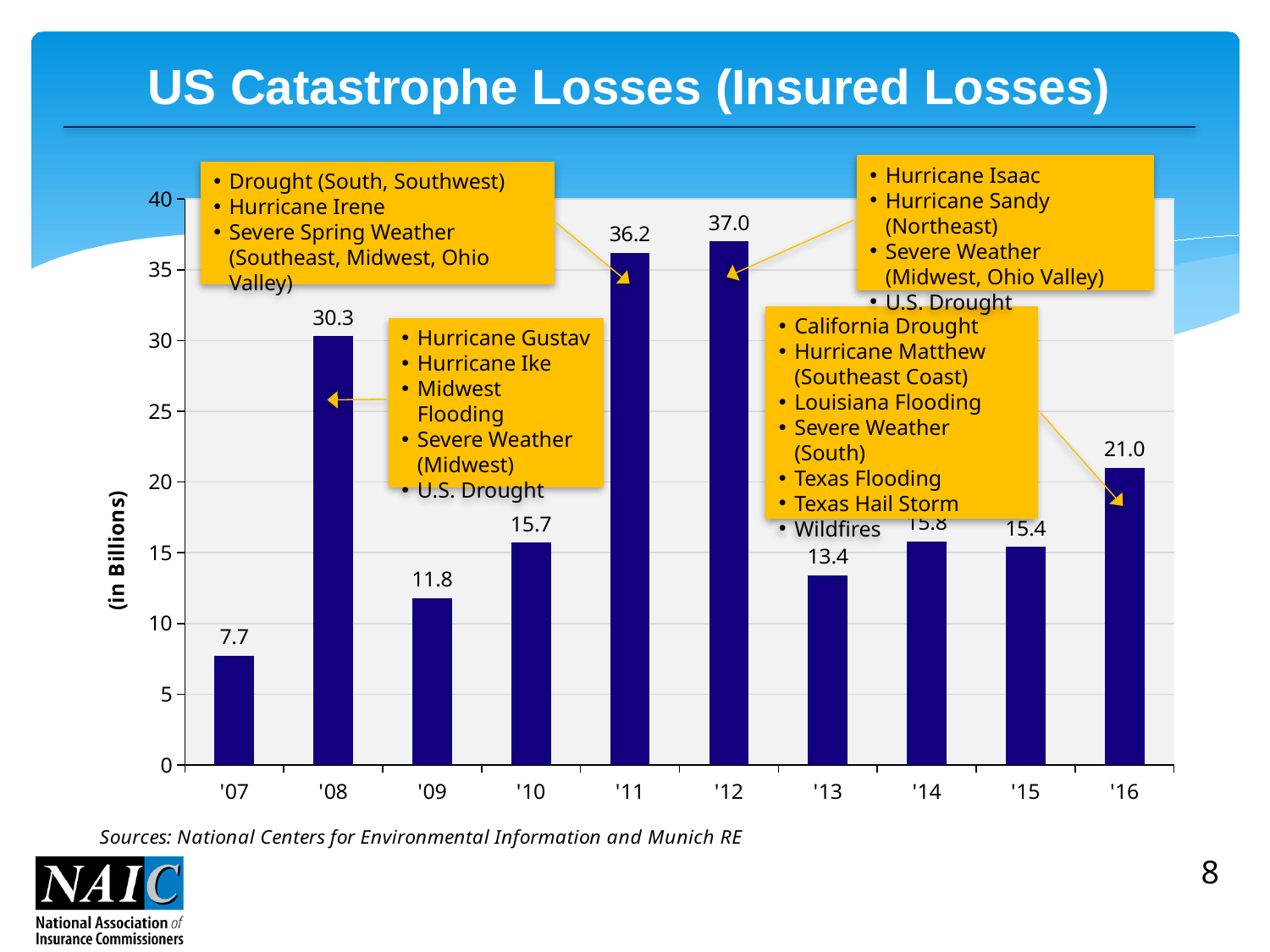
What is the label on the y axis? (in Billions) What is the difference between the values for '12 and '11? 0.8 Which year has the highest insured losses? '12 How many years are shown on the x axis? 10 Which is larger, the value for '08 or the value for '16? '08 What is the difference between the values for '16 and '13? 7.6 What kind of chart is shown on the slide? bar chart What is the value for '07? 7.7 Which year has the lowest insured losses? '07 What is the value for '09? 11.8 What is the value for '12? 37.0 Is the value for '15 greater or less than 20? less